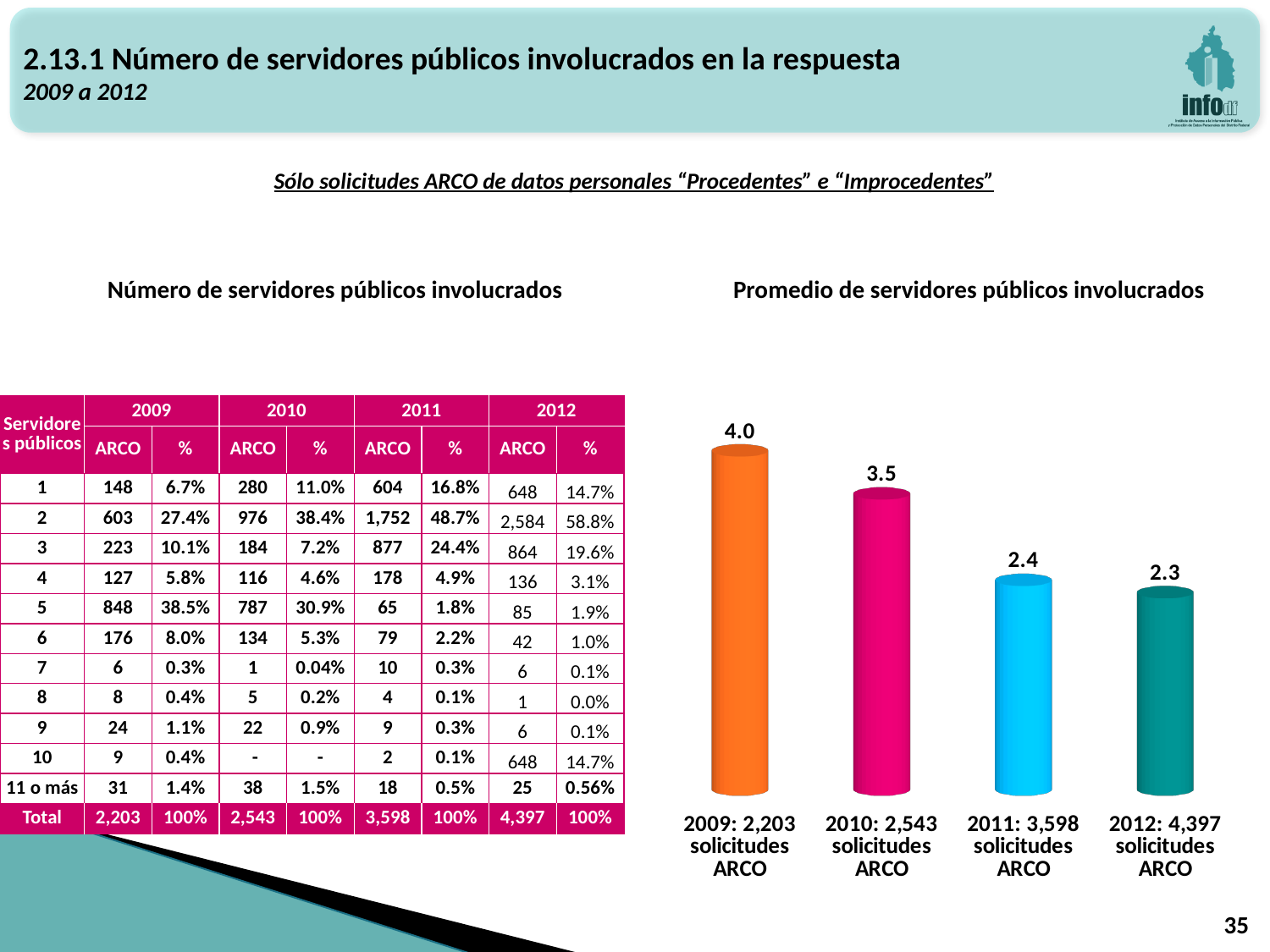
In the chart 'Promedio de servidores públicos involucrados', what is the value for 2010? 3.5 What kind of chart is 'Promedio de servidores públicos involucrados'? Bar chart In the chart 'Promedio de servidores públicos involucrados', what is the value for 2012? 2.3 In the chart 'Promedio de servidores públicos involucrados', what is the value for 2011? 2.4 In the chart 'Promedio de servidores públicos involucrados', what is the value for 2009? 4.0 In the chart 'Promedio de servidores públicos involucrados', do the values rise or fall from 2009 to 2012? Fall In the chart 'Promedio de servidores públicos involucrados', which year has the lowest value? 2012 In the chart 'Promedio de servidores públicos involucrados', what is the difference between the values for 2010 and 2011? 1.1 In the chart 'Promedio de servidores públicos involucrados', what is the difference between the values for 2009 and 2012? 1.7 How many bars are shown in the chart 'Promedio de servidores públicos involucrados'? 4 In the chart 'Promedio de servidores públicos involucrados', which year has the highest value? 2009 In the chart 'Promedio de servidores públicos involucrados', which is larger, the value for 2010 or the value for 2011? 2010